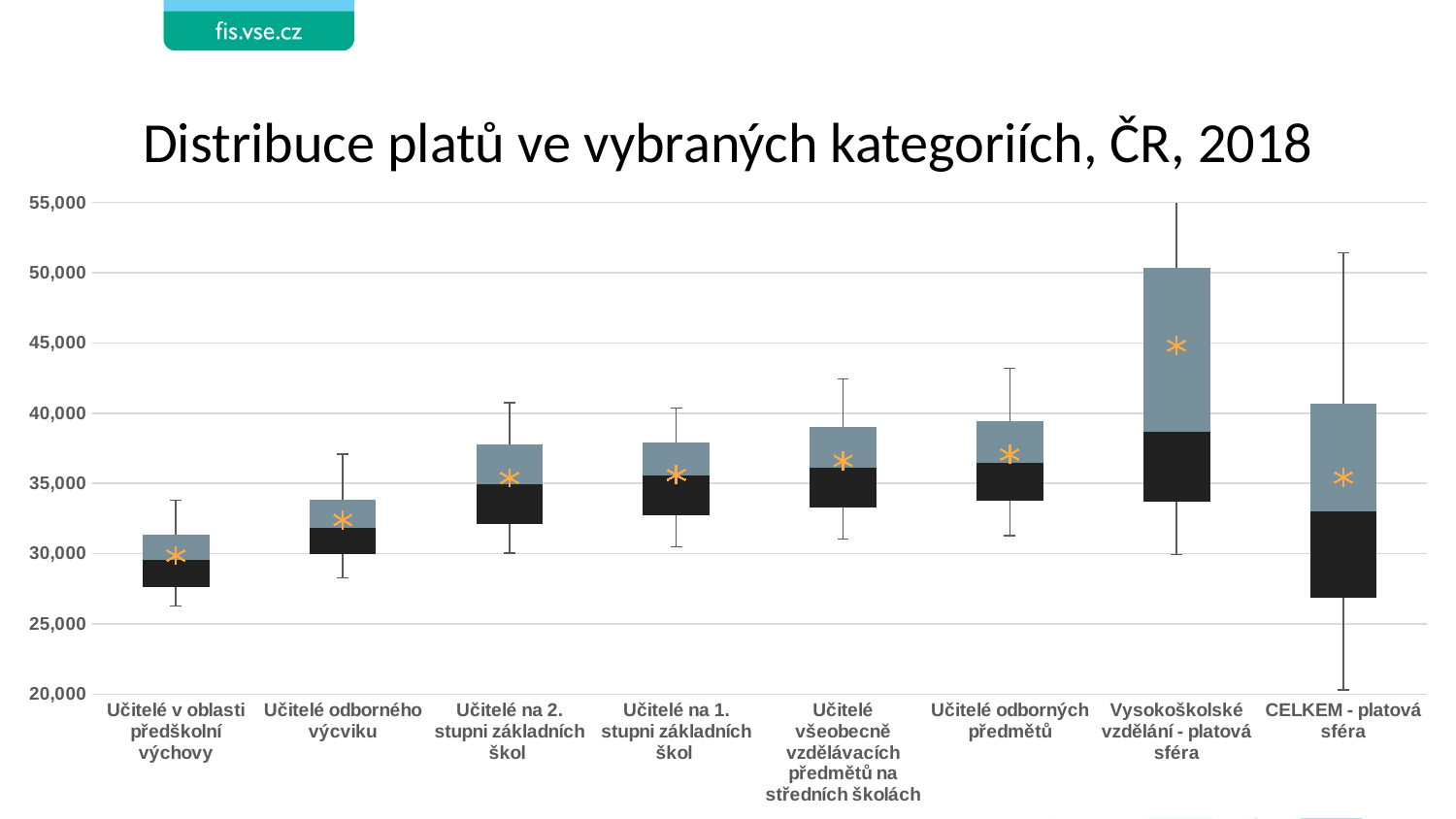
Which category's lower whisker reaches the lowest value on the chart? CELKEM - platová sféra What is the title of the chart? Distribuce platů ve vybraných kategoriích, ČR, 2018 Moving from Učitelé v oblasti předškolní výchovy to Vysokoškolské vzdělání - platová sféra, do the mean markers generally rise or fall? rise Which category has the highest mean marker (orange asterisk)? Vysokoškolské vzdělání - platová sféra Which category has the lowest mean marker (orange asterisk)? Učitelé v oblasti předškolní výchovy Is the bottom of the box for CELKEM - platová sféra greater or less than 30,000? less What kind of chart is shown on the slide? Box plot (box-and-whisker chart) How many categories are shown along the x axis? 8 Which has the higher mean marker: Učitelé odborného výcviku or Učitelé na 2. stupni základních škol? Učitelé na 2. stupni základních škol Is the mean marker for Učitelé v oblasti předškolní výchovy greater or less than 35,000? less Is the mean marker for Vysokoškolské vzdělání - platová sféra greater or less than 40,000? greater